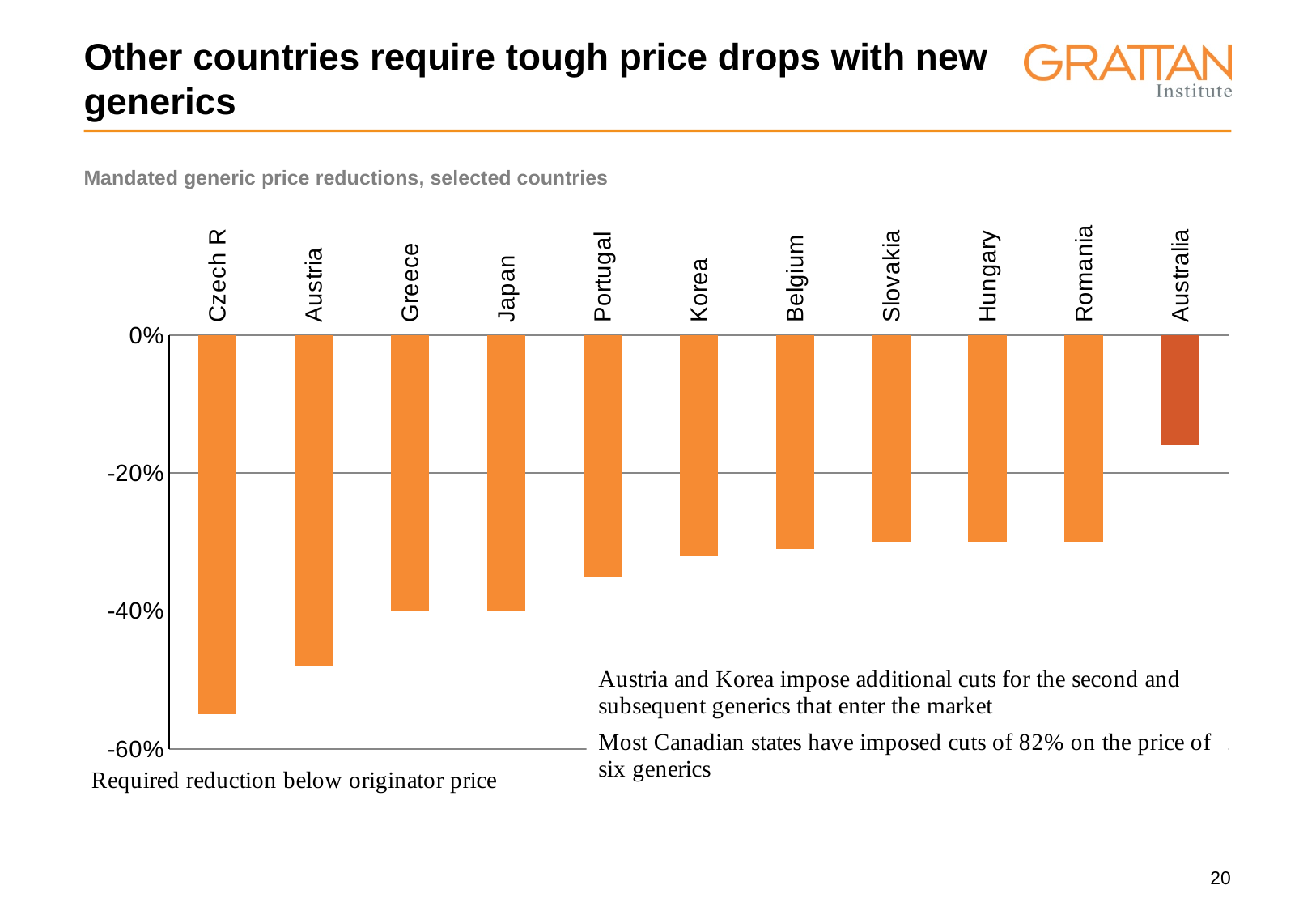
Is the value for Czech R greater or less than -40%? less Which country has the largest mandated generic price reduction? Czech R How many countries are shown in the chart? 11 Which country's bar is shown in a different, darker colour from the others? Australia Which country has a larger price reduction, Austria or Portugal? Austria What is the mandated generic price reduction for Japan? -40% Is the value for Korea greater or less than -40%? greater What kind of chart is shown on the slide? bar chart Moving from left to right across the chart, do the mandated price reductions get larger or smaller in magnitude? smaller Which country has the smallest mandated generic price reduction? Australia Is the value for Australia greater or less than -20%? greater What is the mandated generic price reduction for Greece? -40%